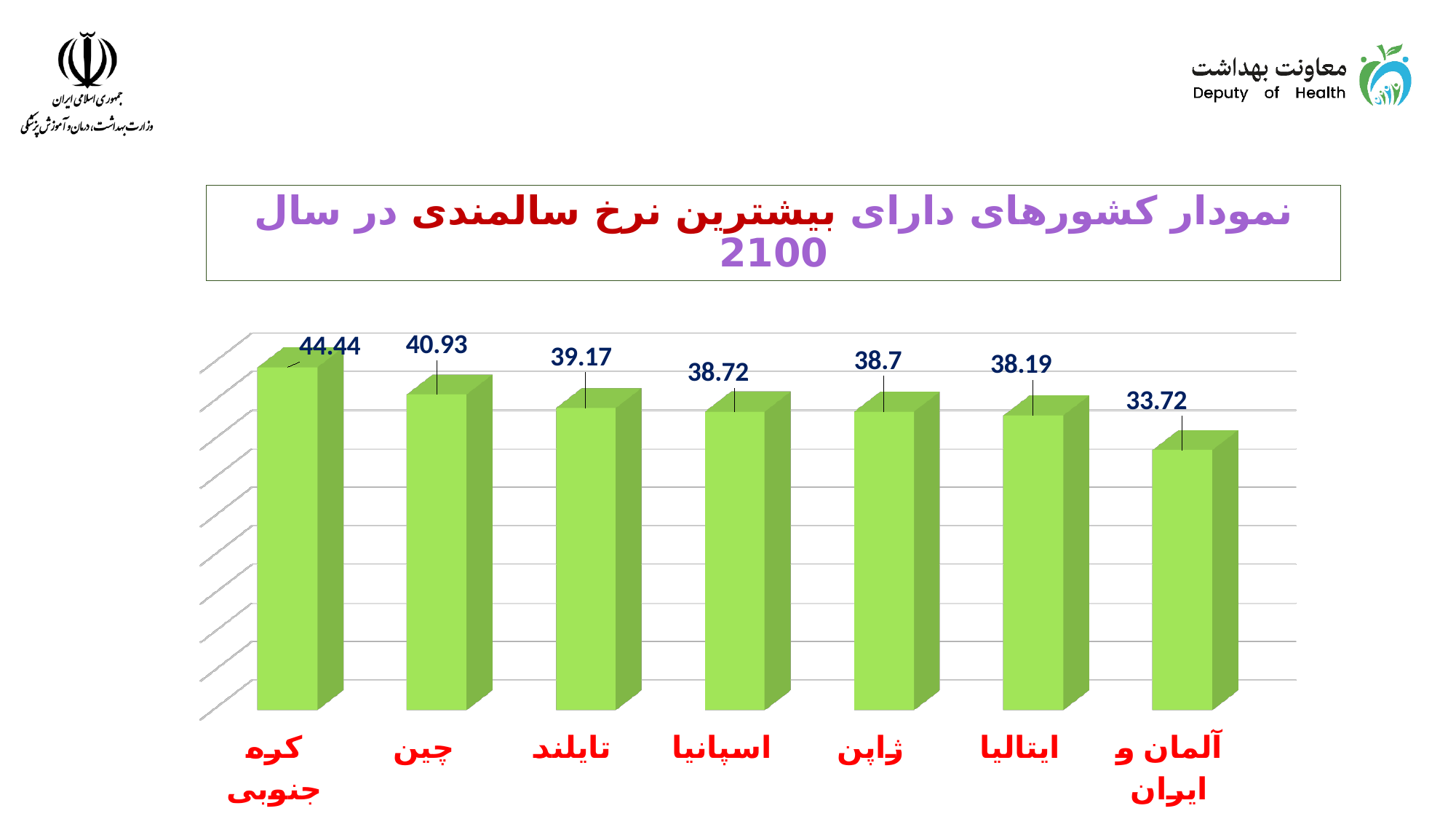
What is the value for چین (China)? 40.93 What is the value for آلمان و ایران (Germany and Iran)? 33.72 What type of chart is shown on the slide? bar chart What is the difference between the values for ایتالیا and آلمان و ایران? 4.47 How many countries (categories) are shown in the chart? 7 What is the difference between the values for کره جنوبی and چین? 3.51 Do the values rise or fall moving from left to right along the x axis? fall What is the value for ژاپن (Japan)? 38.7 Which category has the lowest value? آلمان و ایران Which category has the highest value? کره جنوبی Which is larger, the value for تایلند or the value for ایتالیا? تایلند What is the value for کره جنوبی (South Korea)? 44.44